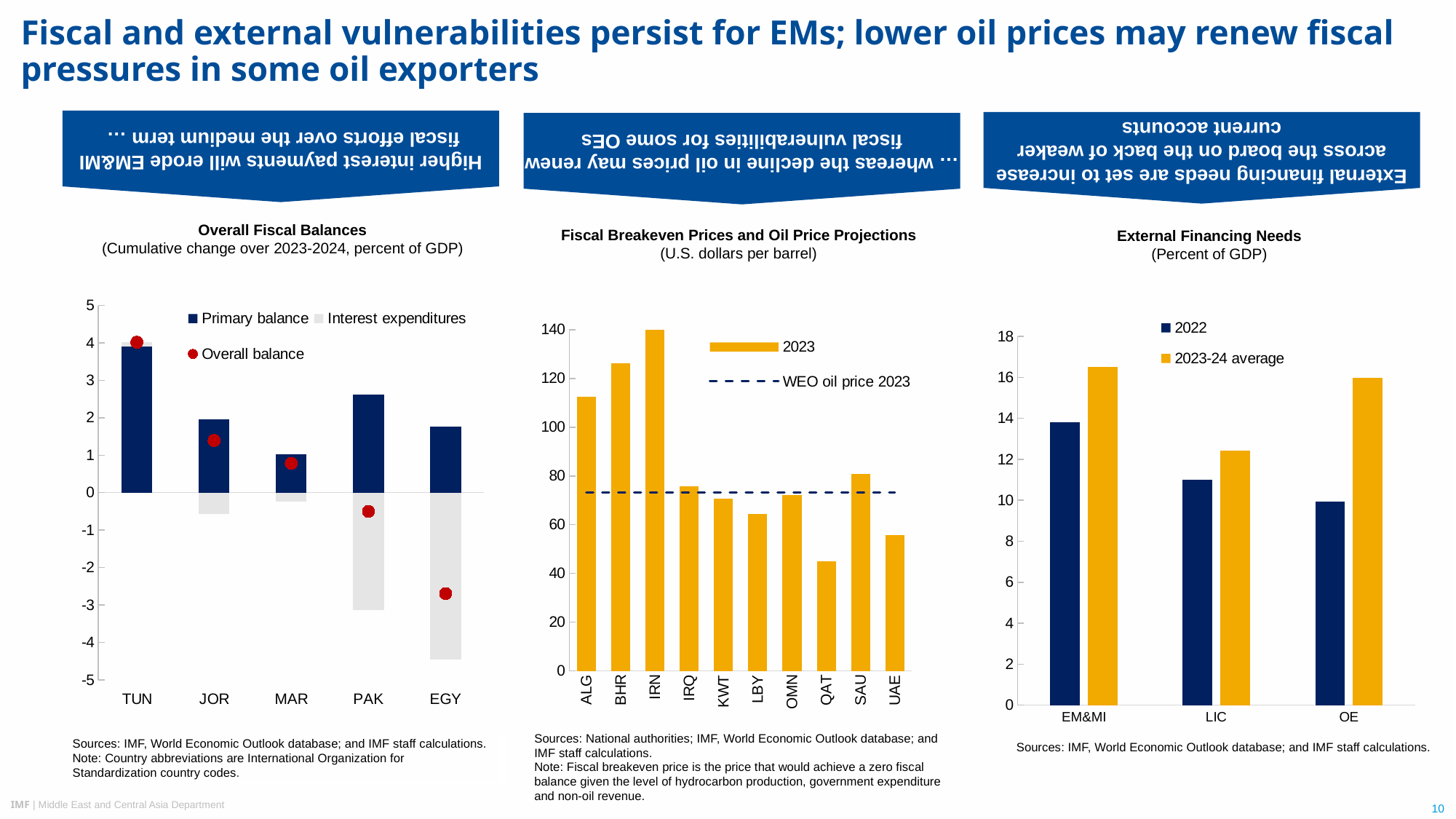
In the Overall Fiscal Balances chart, how many countries are shown on the x axis? 5 In the External Financing Needs chart, is the 2023-24 average value for OE greater or less than 14? greater In the Fiscal Breakeven Prices and Oil Price Projections chart, is the 2023 value for ALG greater or less than 100? greater In the Fiscal Breakeven Prices and Oil Price Projections chart, which country has the lowest fiscal breakeven price in 2023? QAT In the Overall Fiscal Balances chart, which country has the highest overall balance? TUN In the Fiscal Breakeven Prices and Oil Price Projections chart, how many countries are shown on the x axis? 10 In the Overall Fiscal Balances chart, how many entries does the legend list? 3 In the External Financing Needs chart, which category has the lowest value for 2022? OE What kind of chart is the External Financing Needs chart? bar chart In the Overall Fiscal Balances chart, is the primary balance for PAK greater or less than 2? greater In the Overall Fiscal Balances chart, which country has the lowest overall balance? EGY In the Fiscal Breakeven Prices and Oil Price Projections chart, which country has the highest fiscal breakeven price in 2023? IRN